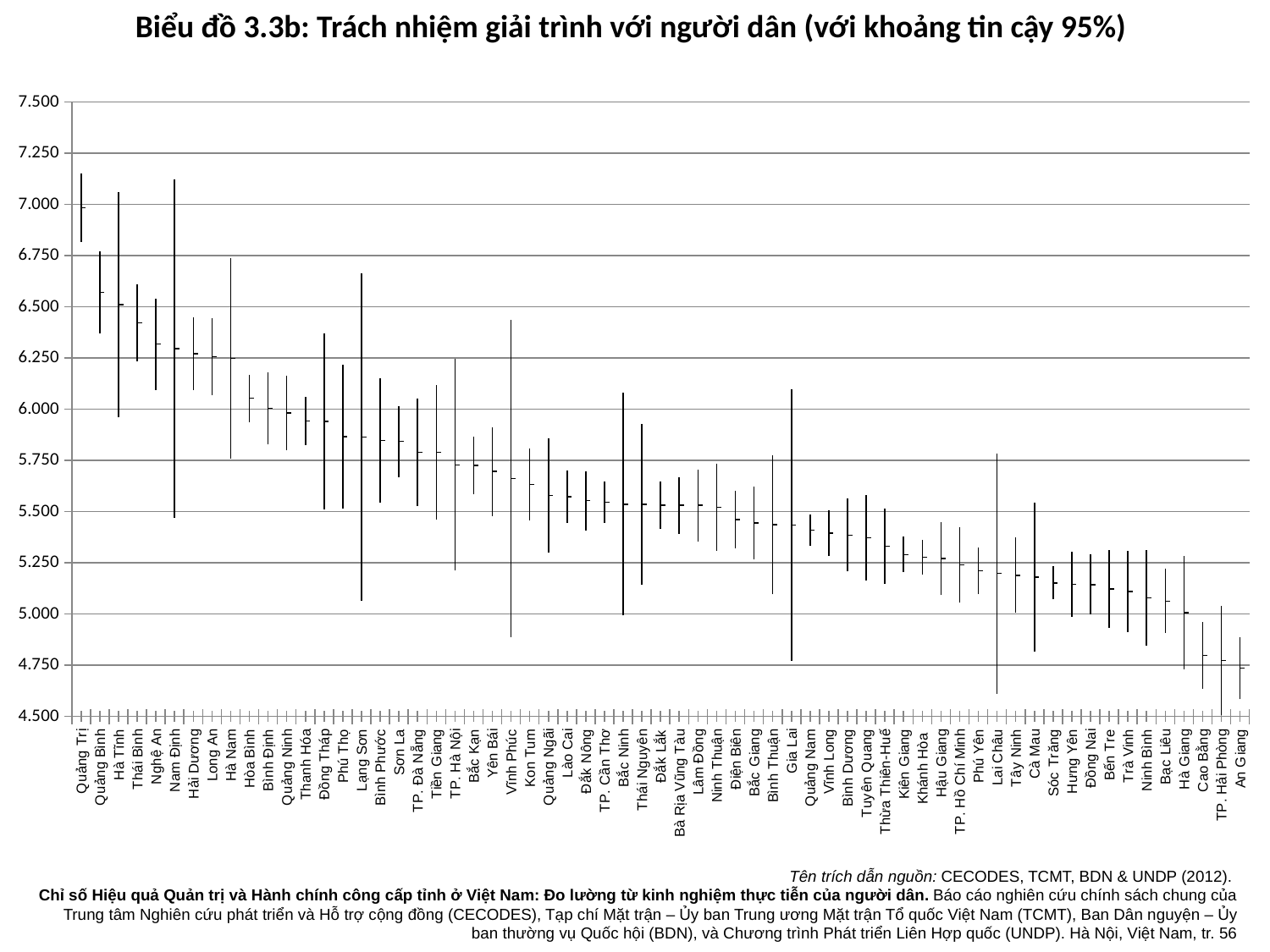
Do the values rise or fall from left to right along the x axis? fall Is the value for Quảng Bình greater or less than 6.500? greater Which has a higher value, Quảng Bình or Lạng Sơn? Quảng Bình Which province has the lowest value in the chart? An Giang How many provinces are plotted on the x axis? 63 What confidence level is stated in the chart title? 95% Is the value for Vĩnh Phúc greater or less than 5.500? greater Which has a higher value, Quảng Trị or An Giang? Quảng Trị Is the value for Bạc Liêu greater or less than 5.000? greater Which province has the highest value in the chart? Quảng Trị